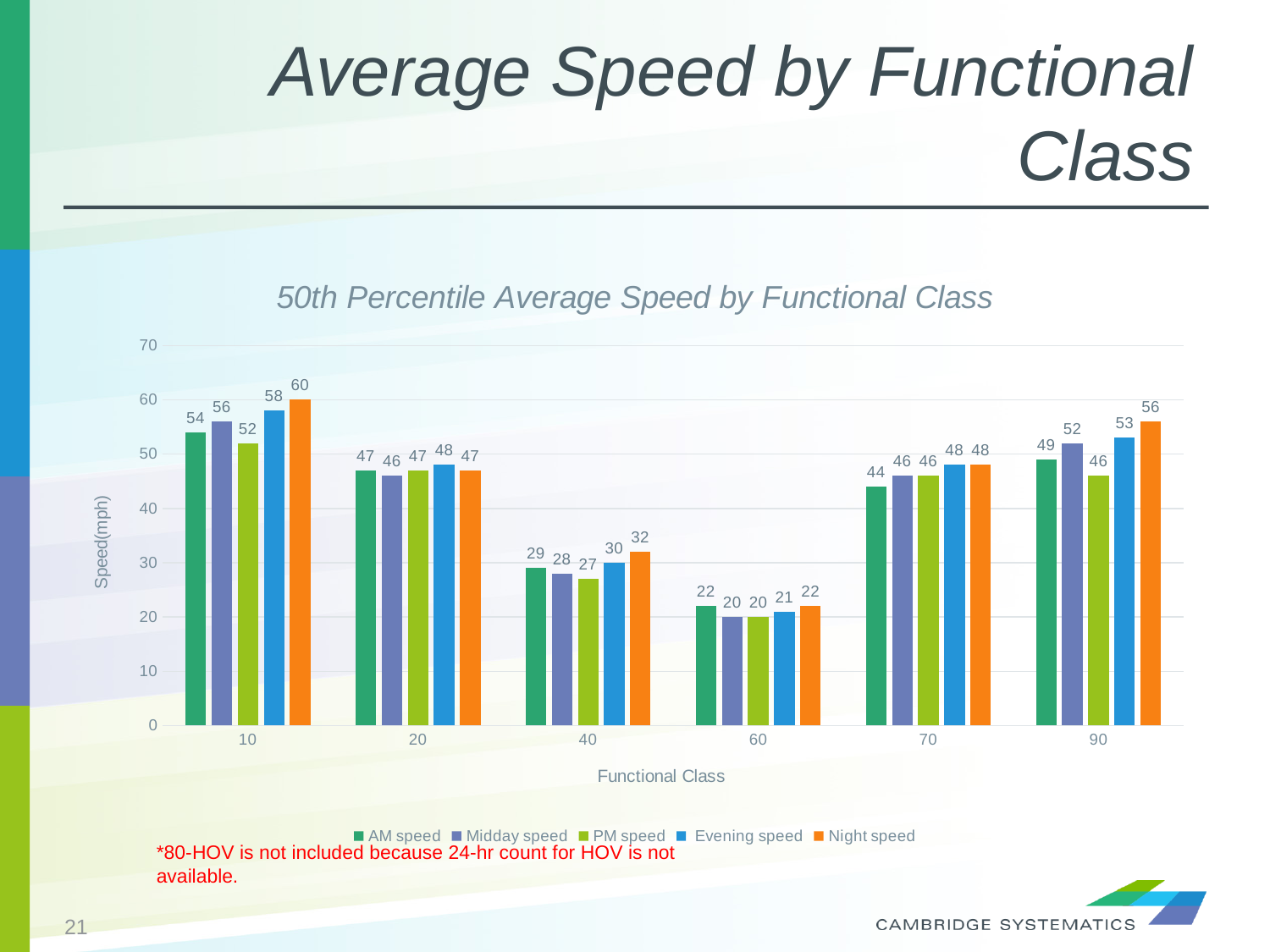
What is the difference between the Night speed and the AM speed for functional class 90? 7 What is the AM speed for functional class 70? 44 What is the Night speed for functional class 10? 60 How many functional classes are shown on the x axis? 6 Which functional class has the highest Night speed? 10 What is the title of the chart? 50th Percentile Average Speed by Functional Class What kind of chart is shown on the slide? Bar chart Which functional class has the lowest AM speed? 60 What is the PM speed for functional class 40? 27 What is the label of the y axis? Speed(mph) How many series does the legend list? 5 Which is larger for functional class 20: the Midday speed or the Evening speed? Evening speed